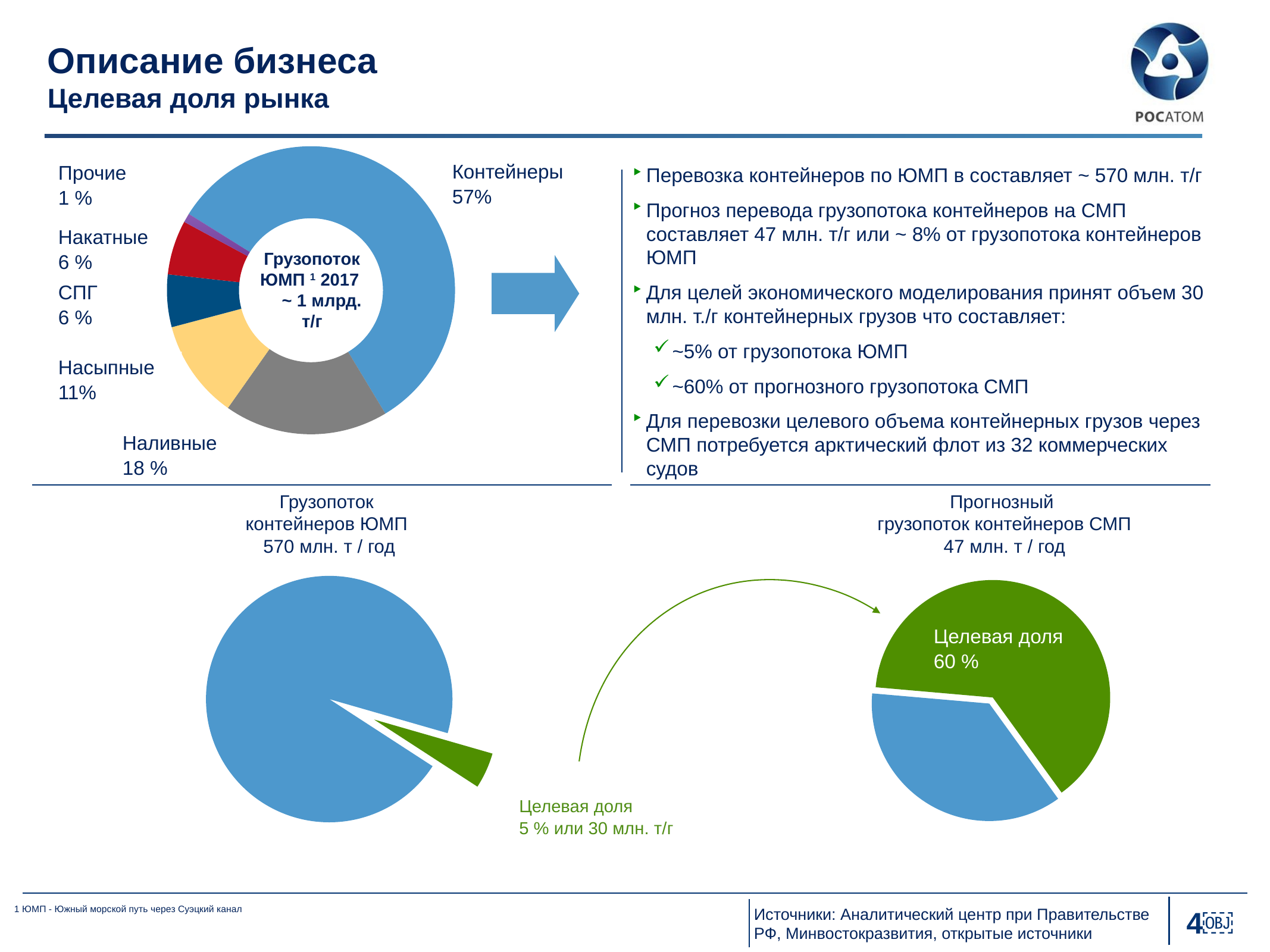
In the top-left donut chart (Грузопоток ЮМП 2017), what share is shown for Наливные? 18 % In the top-left donut chart (Грузопоток ЮМП 2017), which is larger: Насыпные or СПГ? Насыпные In the top-left donut chart (Грузопоток ЮМП 2017), what is the difference in percentage points between Контейнеры and Наливные? 39 In the top-left donut chart (Грузопоток ЮМП 2017), which category has the largest share? Контейнеры What total value is shown in the centre of the top-left donut chart? ~ 1 млрд. т/г In the top-left donut chart (Грузопоток ЮМП 2017), what share is shown for Насыпные? 11% In the bottom-right pie chart (Прогнозный грузопоток контейнеров СМП 47 млн. т / год), what is the target share (Целевая доля)? 60 % In the top-left donut chart (Грузопоток ЮМП 2017), how many categories are shown? 6 In the top-left donut chart (Грузопоток ЮМП 2017), which category has the smallest share? Прочие In the bottom-left pie chart (Грузопоток контейнеров ЮМП 570 млн. т / год), what is the target share (Целевая доля)? 5 % или 30 млн. т/г In the top-left donut chart (Грузопоток ЮМП 2017), what share is shown for Контейнеры? 57% What kind of chart is the top-left chart (Грузопоток ЮМП 2017)? Donut (pie) chart